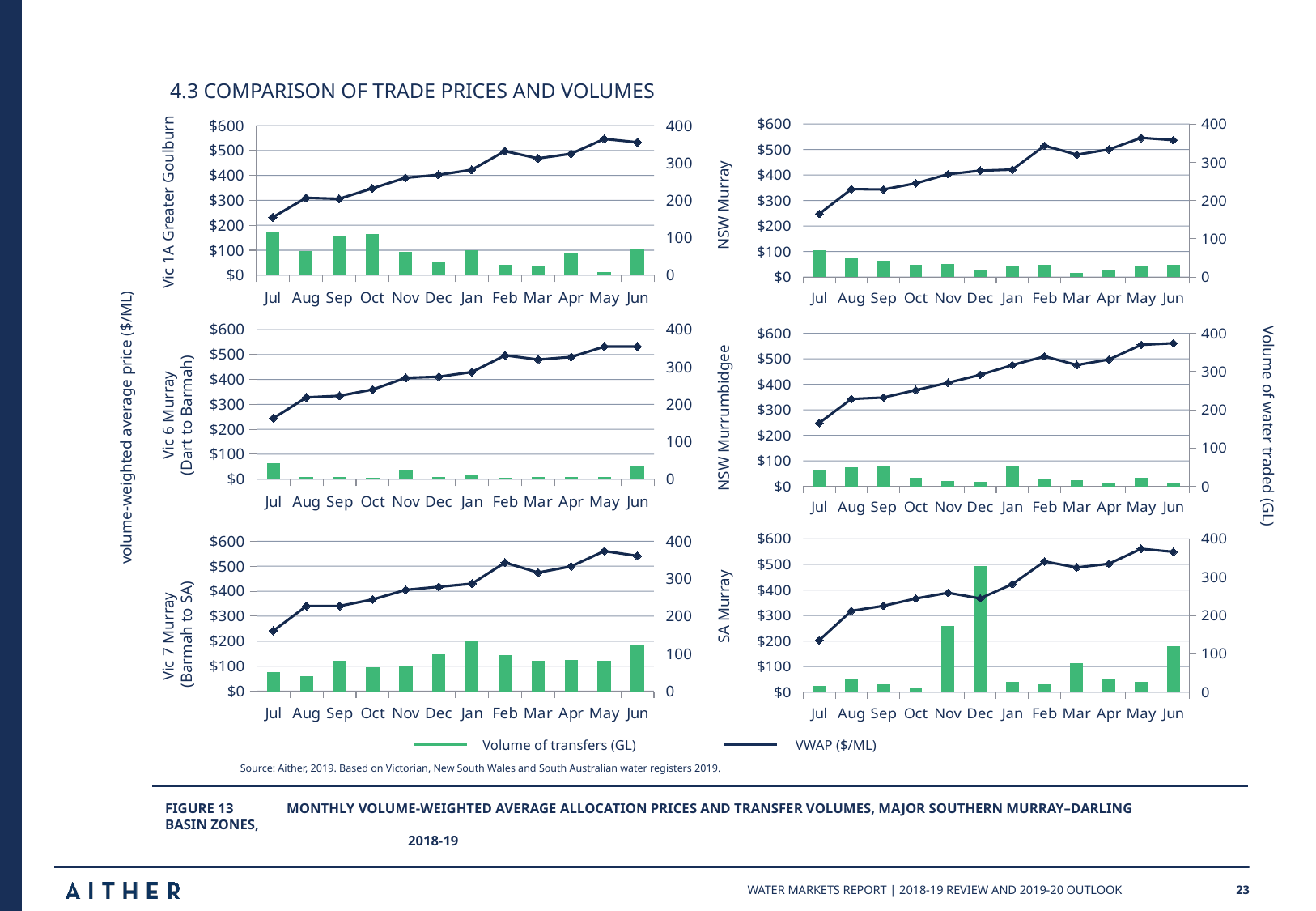
In the Vic 1A Greater Goulburn chart, is the VWAP for Jul greater or less than $300? less What are the two series named in the legend? Volume of transfers (GL) and VWAP ($/ML) In the Vic 1A Greater Goulburn chart, which month has the lowest volume of transfers? May In the Vic 7 Murray (Barmah to SA) chart, which month has the highest volume of transfers? Jan How many series does the legend list? 2 In the SA Murray chart, which month has the highest volume of transfers? Dec In the Vic 1A Greater Goulburn chart, how many months are plotted along the x axis? 12 In the NSW Murray chart, does the VWAP line generally rise or fall from Jul to Jun? rise In the SA Murray chart, which month has the larger volume of transfers, Nov or Dec? Dec How many charts are shown on the slide? 6 In the SA Murray chart, is the volume of transfers for Dec greater or less than 300? greater In the Vic 1A Greater Goulburn chart, which month has the highest volume of transfers? Jul